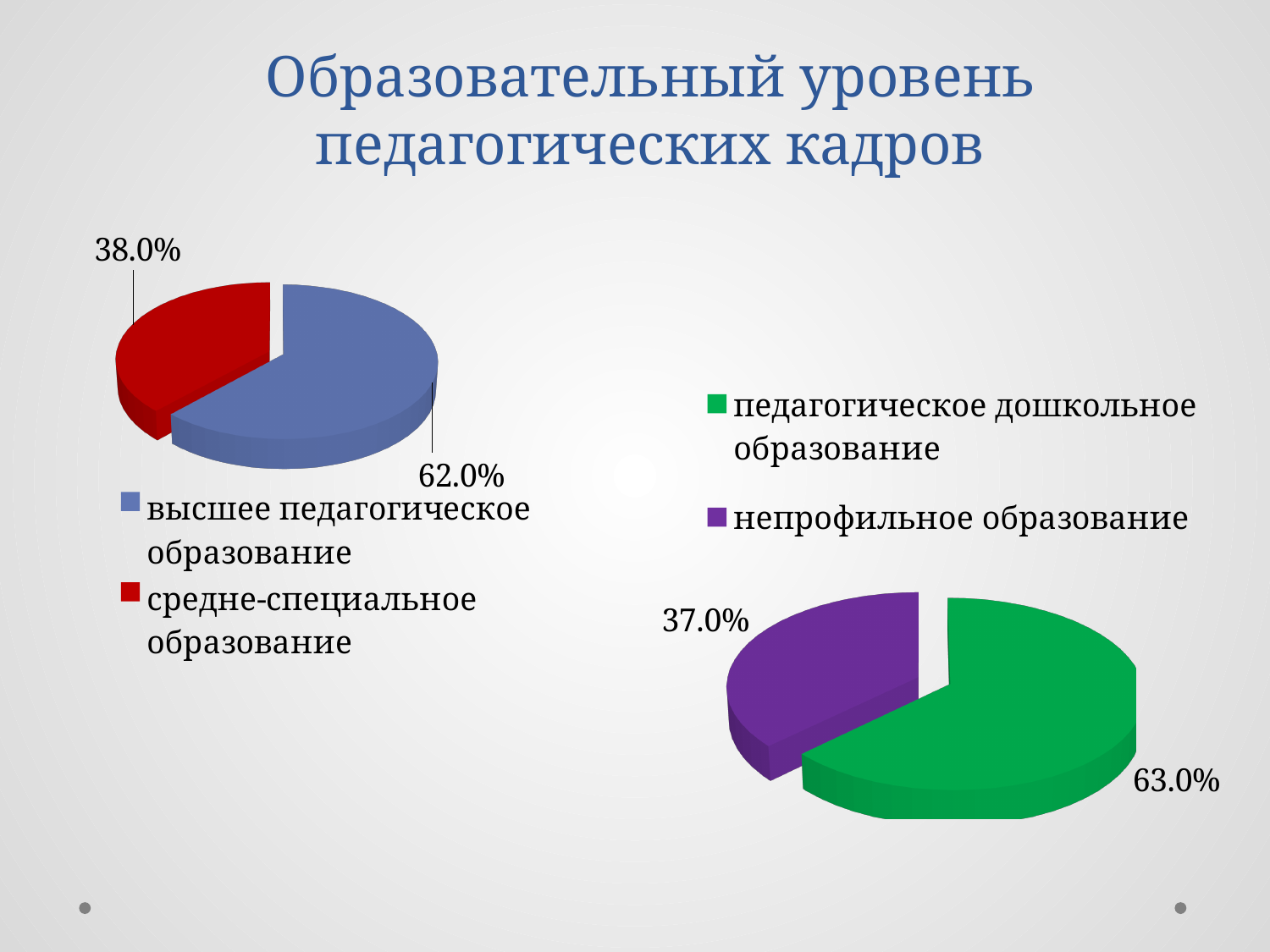
In the pie chart on the right of the slide, which is larger: the slice for 'педагогическое дошкольное образование' or the slice for 'непрофильное образование'? педагогическое дошкольное образование In the pie chart on the left of the slide, what colour is the slice for 'средне-специальное образование'? Red In the pie chart on the right of the slide, what is the difference between the shares for 'педагогическое дошкольное образование' and 'непрофильное образование'? 26.0% In the pie chart on the left of the slide, which category has the largest slice? высшее педагогическое образование In the pie chart on the right of the slide, what share is labelled for 'непрофильное образование'? 37.0% How many slices does the pie chart on the left of the slide have? 2 In the pie chart on the left of the slide, what share is labelled for 'средне-специальное образование'? 38.0% In the pie chart on the left of the slide, what share is labelled for 'высшее педагогическое образование'? 62.0% In the pie chart on the right of the slide, what share is labelled for 'педагогическое дошкольное образование'? 63.0% What kind of chart is shown on the right of the slide? Pie chart In the pie chart on the left of the slide, what is the difference between the shares for 'высшее педагогическое образование' and 'средне-специальное образование'? 24.0% In the pie chart on the right of the slide, which category has the smallest slice? непрофильное образование